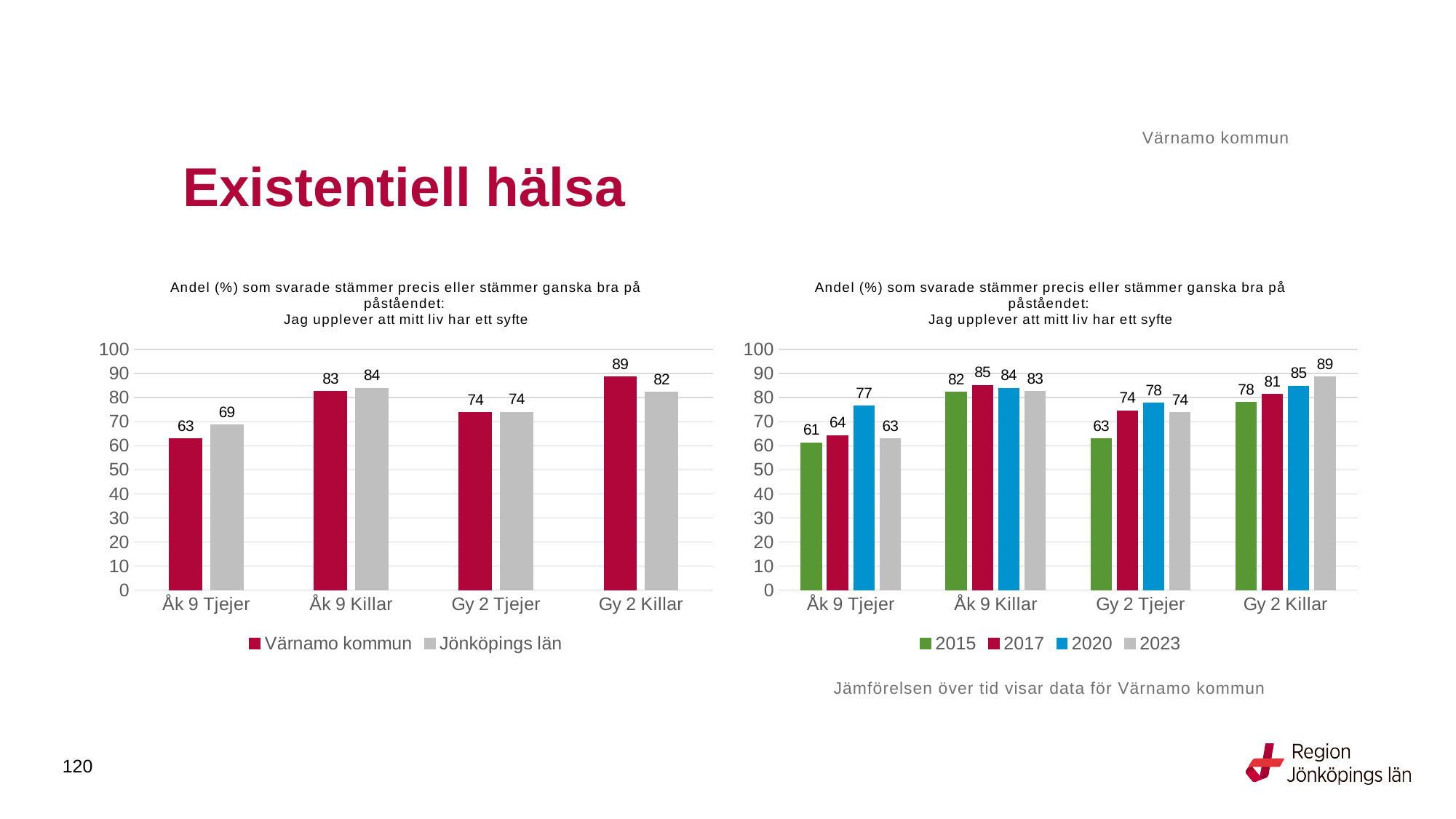
In the left chart, which is larger for Gy 2 Killar: Värnamo kommun or Jönköpings län? Värnamo kommun In the right chart, what is the value for 2015 for Gy 2 Tjejer? 63 In the left chart, which category has the highest value for Värnamo kommun? Gy 2 Killar In the left chart, what is the difference between Jönköpings län and Värnamo kommun for Åk 9 Tjejer? 6 What kind of chart is the right chart? Bar chart In the left chart, what is the value for Värnamo kommun for Åk 9 Tjejer? 63 In the right chart, which category has the lowest value for 2015? Åk 9 Tjejer In the left chart, what is the value for Jönköpings län for Gy 2 Killar? 82 In the right chart, what is the difference between 2023 and 2015 for Gy 2 Killar? 11 In the right chart, how many series does the legend list? 4 In the left chart, how many series does the legend list? 2 In the right chart, what is the value for 2020 for Åk 9 Tjejer? 77